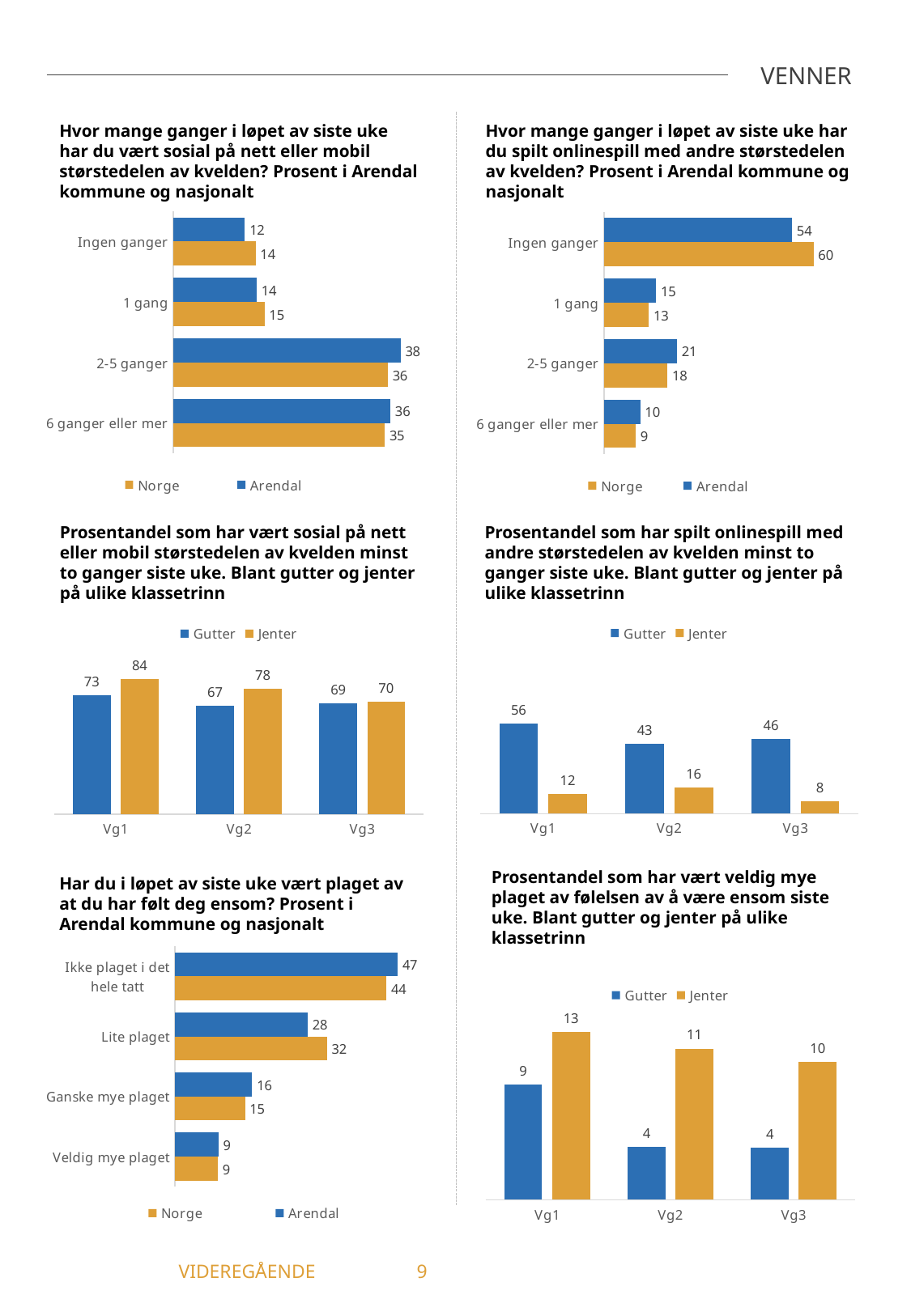
In the bottom-left chart (plaget av å ha følt deg ensom), which is larger for 'Lite plaget': Norge or Arendal? Norge In the bottom-right chart (veldig mye plaget av ensomhet, gutter og jenter), what is the value for Jenter at Vg2? 11 In the top-left chart (sosial på nett eller mobil), what is the value for Norge for 'Ingen ganger'? 14 In the top-left chart (sosial på nett eller mobil), what is the value for Arendal for '2-5 ganger'? 38 In the top-right chart (spilt onlinespill), what is the difference between Norge and Arendal for 'Ingen ganger'? 6 In the middle-left chart (sosial på nett minst to ganger, gutter og jenter), which class level has the lowest value for Gutter? Vg2 In the middle-right chart (spilt onlinespill minst to ganger, gutter og jenter), what is the difference between Gutter and Jenter at Vg1? 44 In the top-right chart (spilt onlinespill), what is the value for Arendal for '6 ganger eller mer'? 10 In the bottom-left chart (plaget av å ha følt deg ensom), how many categories are shown? 4 In the middle-right chart (spilt onlinespill minst to ganger, gutter og jenter), how many series does the legend list? 2 In the middle-left chart (sosial på nett minst to ganger, gutter og jenter), what is the value for Jenter at Vg1? 84 In the top-right chart (spilt onlinespill), which category has the highest value for Norge? Ingen ganger